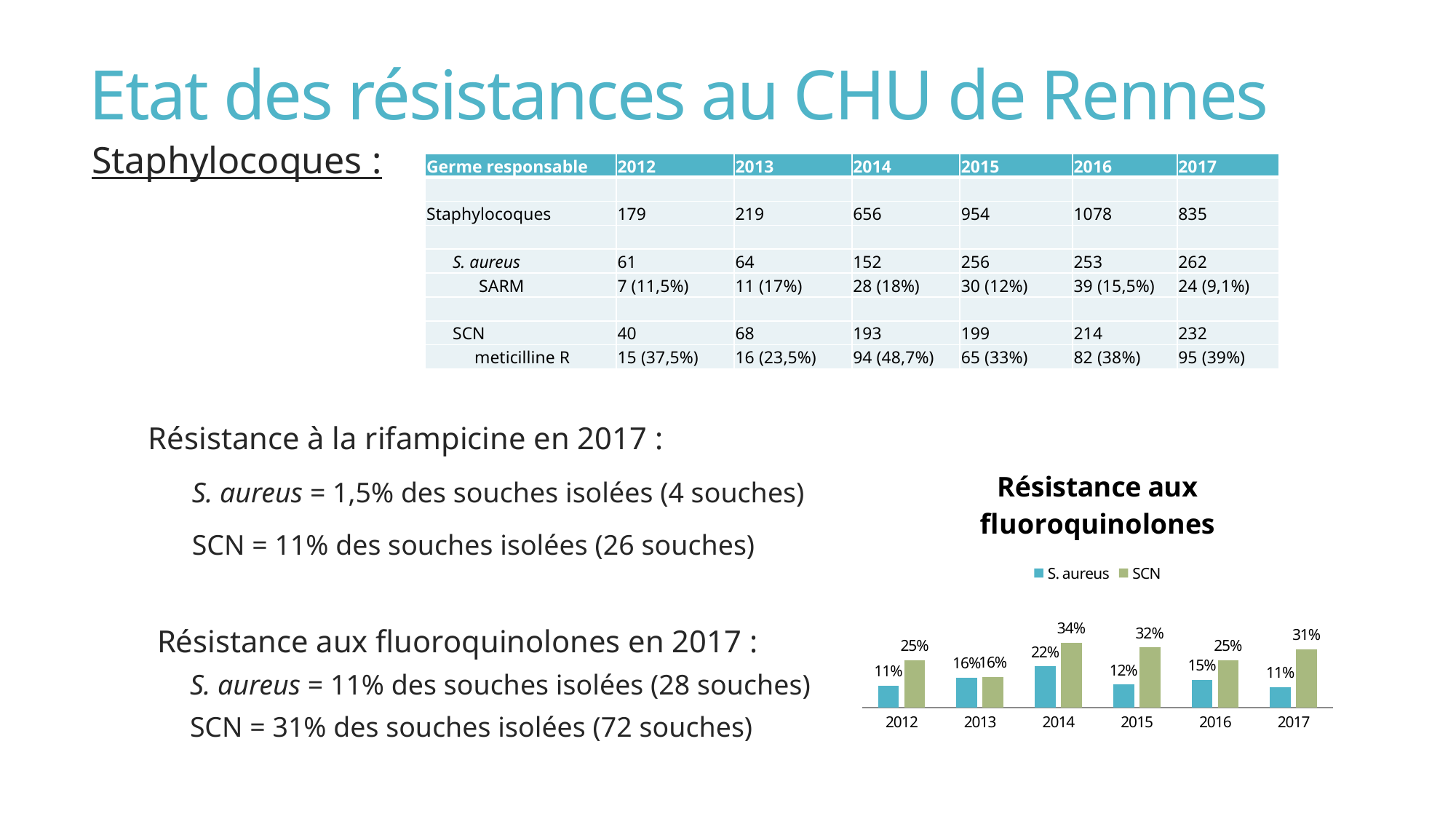
Which is larger in 2016, the S. aureus value or the SCN value? SCN What is the title of the chart on the slide? Résistance aux fluoroquinolones In which year is the SCN value highest? 2014 Which series is shown in green in the chart? SCN How many years are shown on the x axis of the chart? 6 What is the value for SCN in 2013? 16% What is the difference between the SCN and S. aureus values in 2015? 20% In which year is the S. aureus value highest? 2014 What type of chart is shown on the slide? bar chart What is the value for SCN in 2017? 31% What is the value for S. aureus in 2014? 22% How many series does the chart legend list? 2